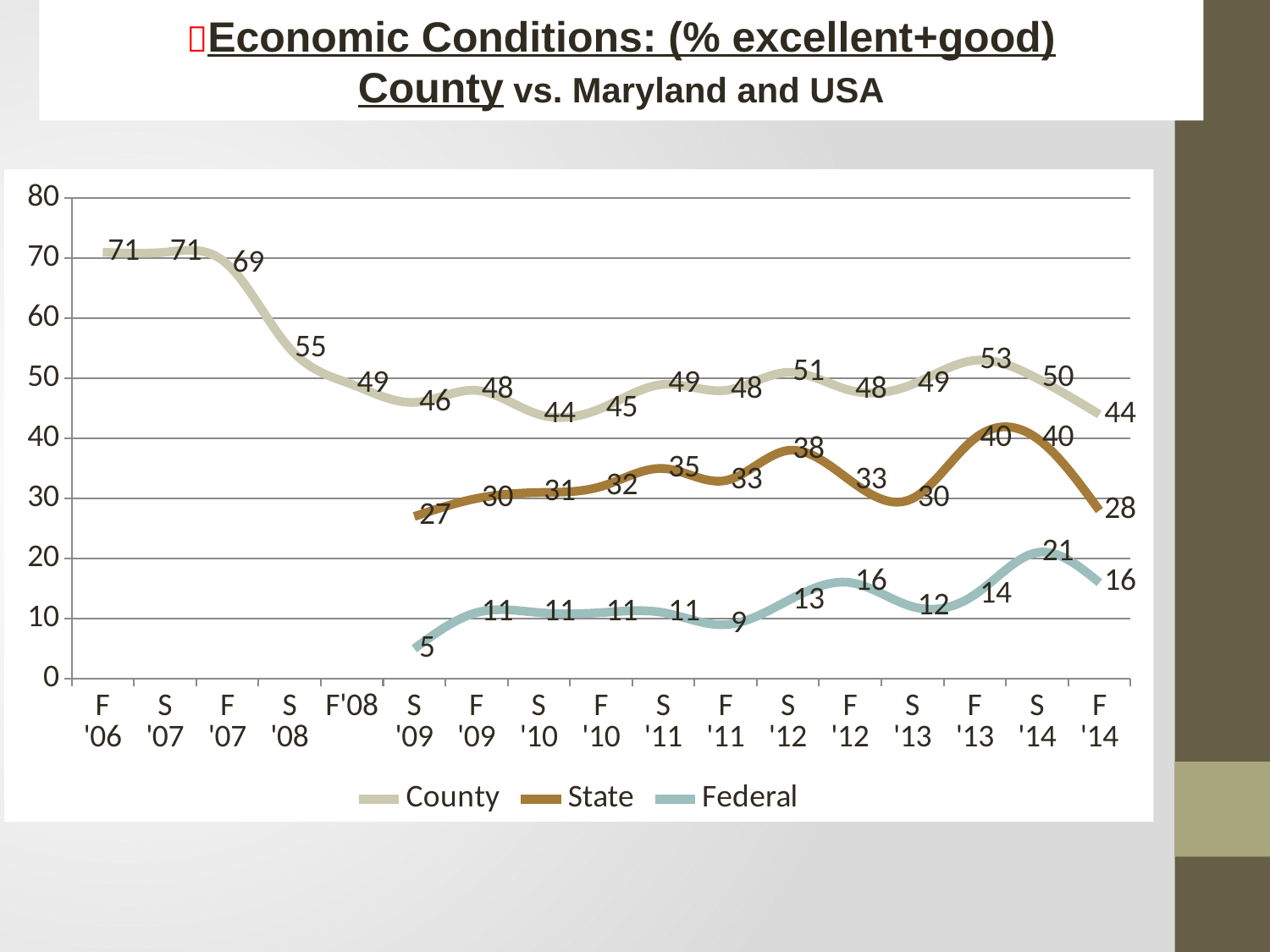
Is the County value for F '07 greater or less than 60? greater What is the difference between the County and State values for F '14? 16 How many periods are shown on the x axis? 17 Does the County series rise or fall from F '06 to S '08? fall What is the State value for S '12? 38 What is the County value for F '06? 71 How many series does the legend list? 3 Which is larger at F '13, the State value or the Federal value? State What kind of chart is shown on the slide? line chart At which period is the Federal series lowest? S '09 What is the Federal value for S '14? 21 At which period is the State series lowest? S '09